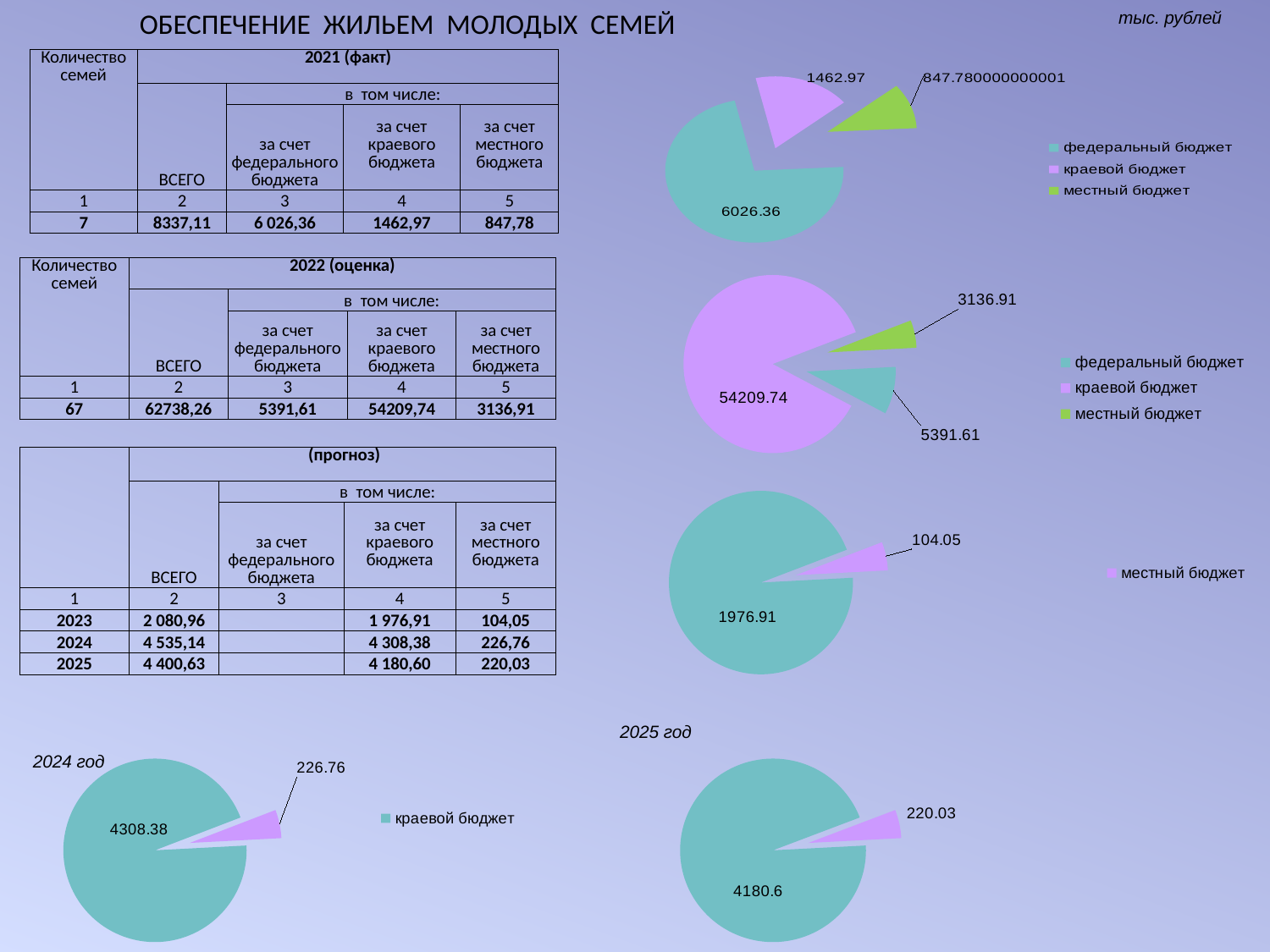
In the pie chart labelled 2024 год, what is the value of the large slice? 4308.38 In the second pie chart from the top on the right side, what value is shown for the федеральный бюджет slice? 5391.61 In the pie chart labelled 2024 год, what is the difference between the two slice values? 4081.62 In the second pie chart from the top on the right side, what is the value of the smallest slice? 3136.91 What type of chart is used in the top-right chart on the slide? pie chart In the pie chart labelled 2025 год, what is the value of the small slice? 220.03 In the third pie chart from the top on the right side, what is the value of the small slice? 104.05 In the top-right pie chart, what value is shown for the краевой бюджет slice? 1462.97 How many entries does the legend of the top-right pie chart list? 3 In the second pie chart from the top on the right side, which slice is larger: 54209.74 or 5391.61? 54209.74 In the top-right pie chart, what is the value of the largest slice? 6026.36 How many slices does the third pie chart from the top on the right side have? 2